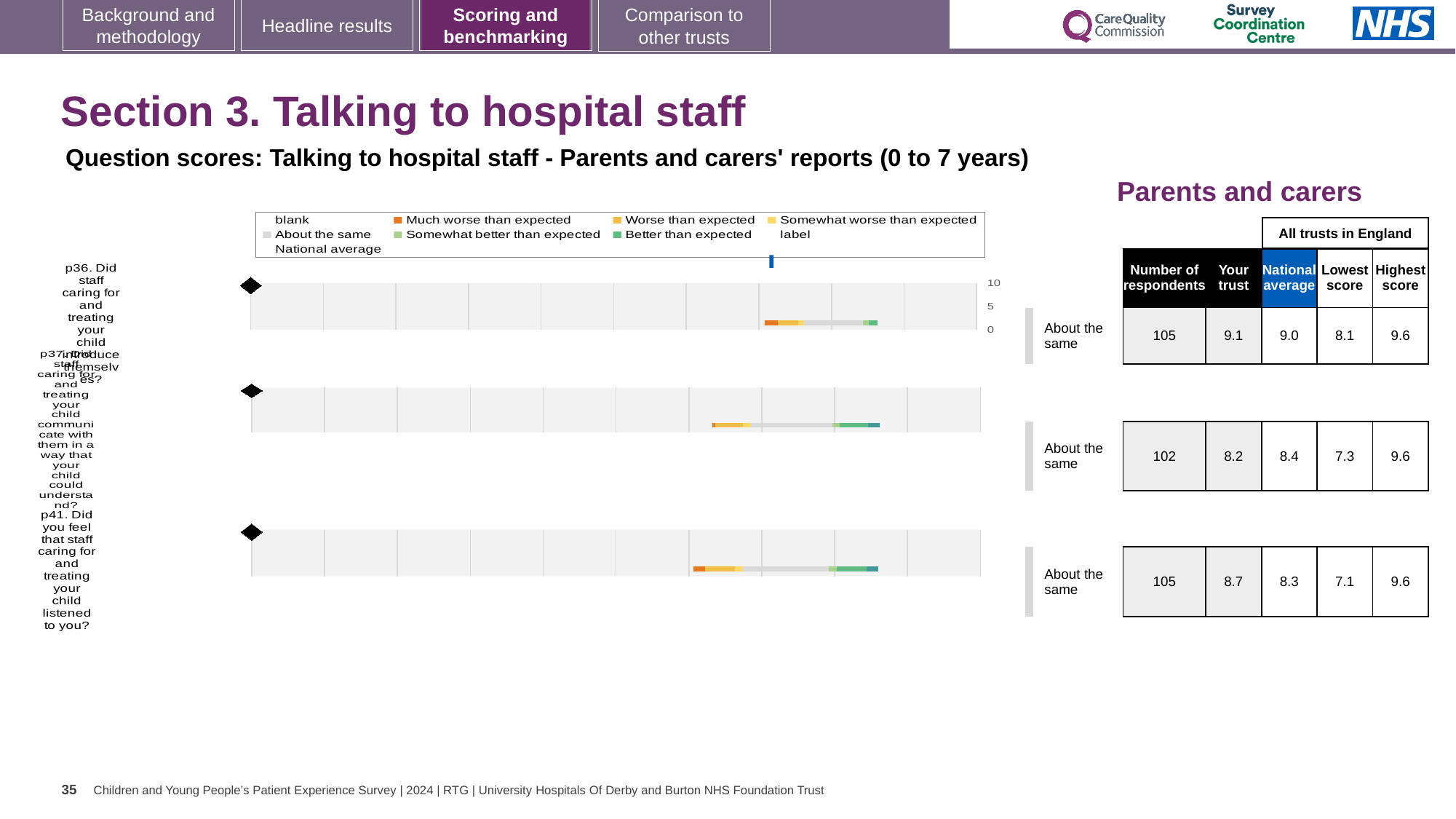
What is the highest score among all trusts in England for p41 (Did you feel that staff listened to you?)? 9.6 For p37, which is larger: the 'Your trust' score or the national average? National average What is the lowest score among all trusts in England for p37? 7.3 Which question has the lowest 'Your trust' score on this slide? p37 For p41, what is the difference between the 'Your trust' score and the national average? 0.4 What kind of chart is used to show each question's score? Bar chart How many question charts are shown on this slide? 3 How many respondents answered p41? 105 Which question has the highest 'Your trust' score on this slide? p36 What is the national average score for p37 (Did staff communicate with them in a way that your child could understand?)? 8.4 What benchmark category is shown next to the chart for p36? About the same What is the 'Your trust' score for p36 (Did staff caring for and treating your child introduce themselves?)? 9.1